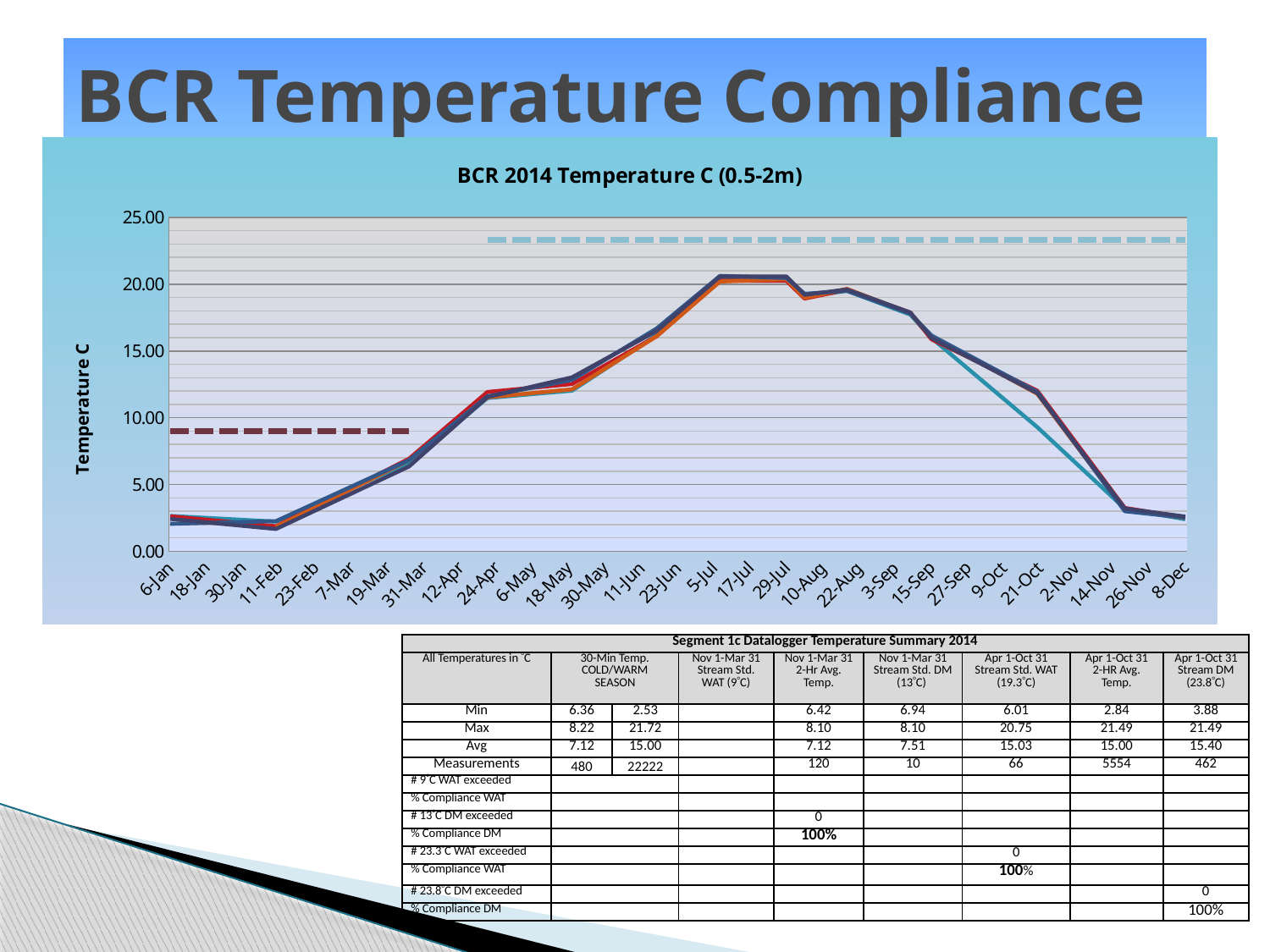
How many date labels are shown along the x axis of the chart? 29 Do the temperature values rise or fall along the x axis from 17-Jul to 8-Dec? fall What is the label on the vertical axis of the chart? Temperature C Is the temperature value for 31-Mar greater or less than 5.00? greater Is the temperature value for 5-Jul greater or less than 15.00? greater What is the title of the chart on the slide? BCR 2014 Temperature C (0.5-2m) What kind of chart is shown on the slide? line chart Which date has the higher temperature value, 5-Jul or 6-Jan? 5-Jul Is the temperature value for 24-Apr greater or less than 15.00? less Which date has the higher temperature value, 22-Aug or 21-Oct? 22-Aug